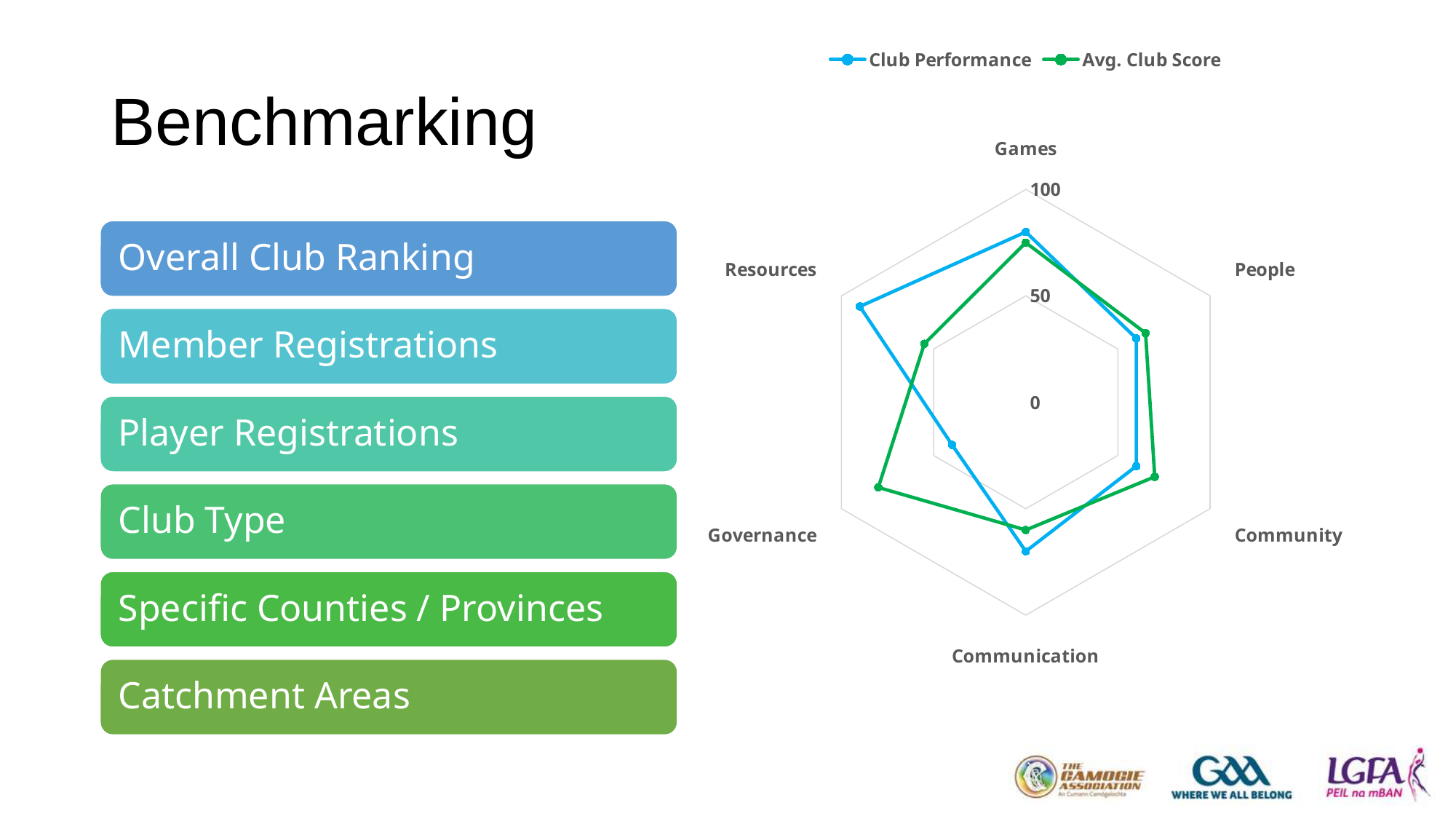
Is the Avg. Club Score value for Governance greater or less than 50? greater Is the Club Performance value for Resources greater or less than 50? greater In which category does Club Performance have its lowest value? Governance For Resources, which series has the larger value: Club Performance or Avg. Club Score? Club Performance In which category does Club Performance have its highest value? Resources Is the Club Performance value for Governance greater or less than 50? less How many categories (axes) does the radar chart have? 6 What kind of chart is shown on the slide? Radar chart For Governance, which series has the larger value: Club Performance or Avg. Club Score? Avg. Club Score How many series does the chart's legend list? 2 What colour is the Club Performance series drawn in? Blue